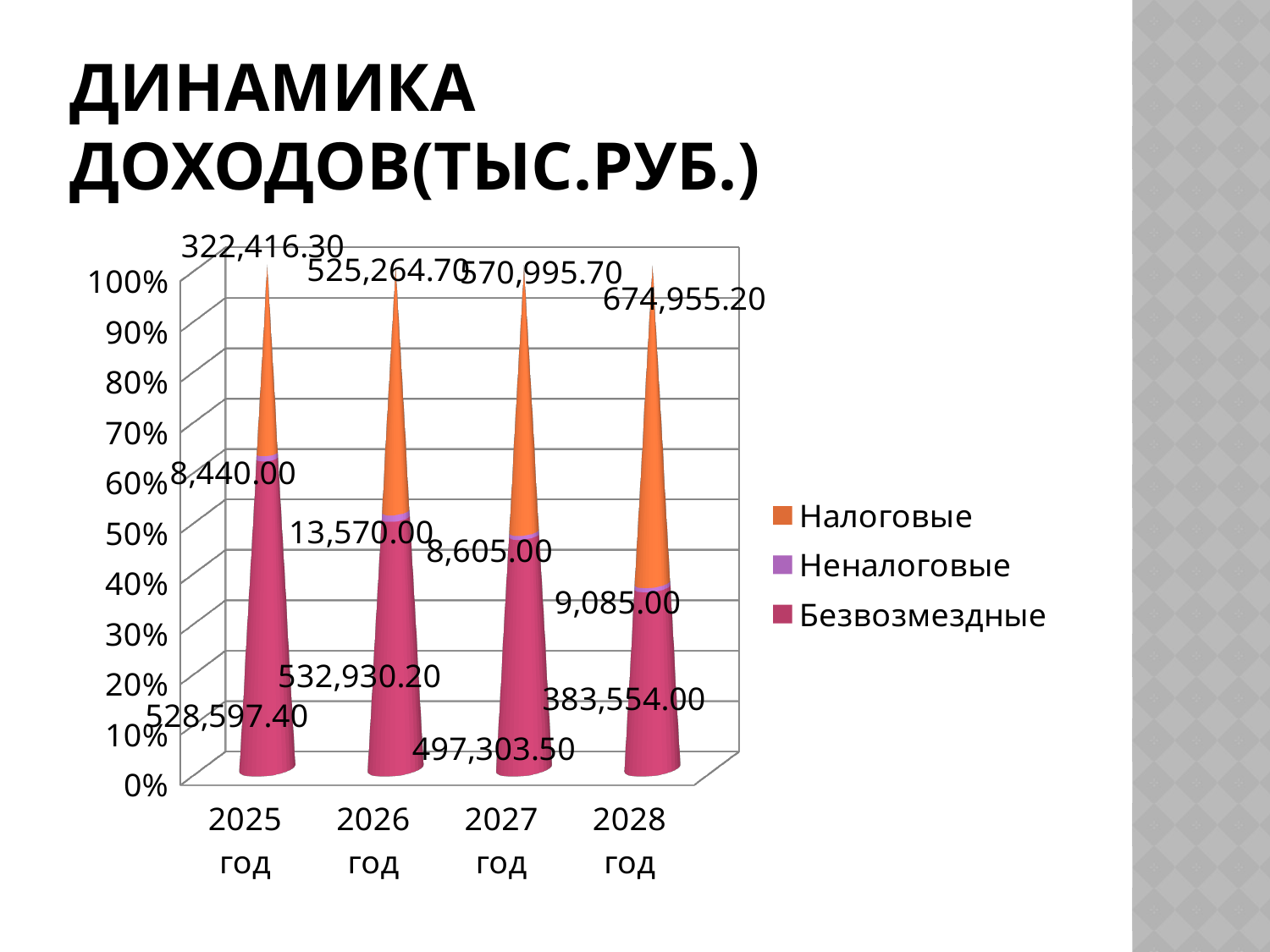
What is the value for Неналоговые in 2026 год? 13,570.00 In which year is the Безвозмездные value the lowest? 2028 год What is the total of the three series for 2028 год? 1,067,594.20 Which is larger: Безвозмездные in 2025 год or Налоговые in 2025 год? Безвозмездные in 2025 год What is the difference between the Налоговые values for 2028 год and 2025 год? 352,538.90 What is the value for Налоговые in 2028 год? 674,955.20 What is the value for Безвозмездные in 2027 год? 497,303.50 In which year is the Налоговые value the highest? 2028 год How many series does the legend list? 3 What kind of chart is shown on the slide? Stacked bar chart How many years are shown on the x axis? 4 Do the Налоговые values rise or fall from 2025 год to 2028 год? Rise